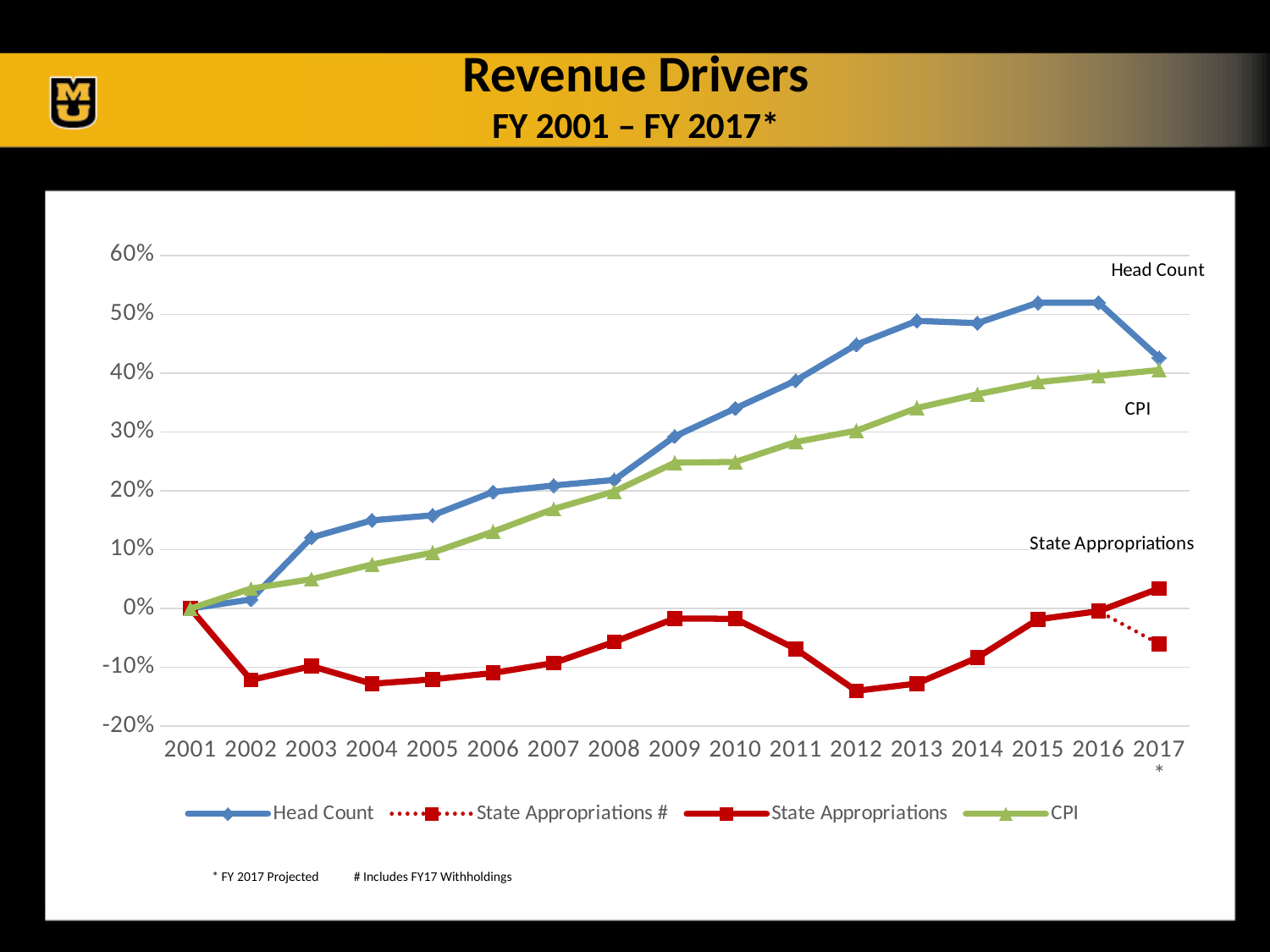
What is the Head Count value in 2001? 0% Is the Head Count value for 2015 greater or less than 50%? greater In 2010, which is larger: Head Count or CPI? Head Count What kind of chart is shown on the slide? line chart Is the Head Count value for 2017 greater or less than 40%? greater What is the title of the chart on the slide? Revenue Drivers FY 2001 – FY 2017* Does the CPI line generally rise or fall from 2001 to 2017? rise How many fiscal years are shown along the x axis? 17 Is the CPI value for 2013 greater or less than 30%? greater How many series does the legend list? 4 Which series has the lowest value in 2012? State Appropriations